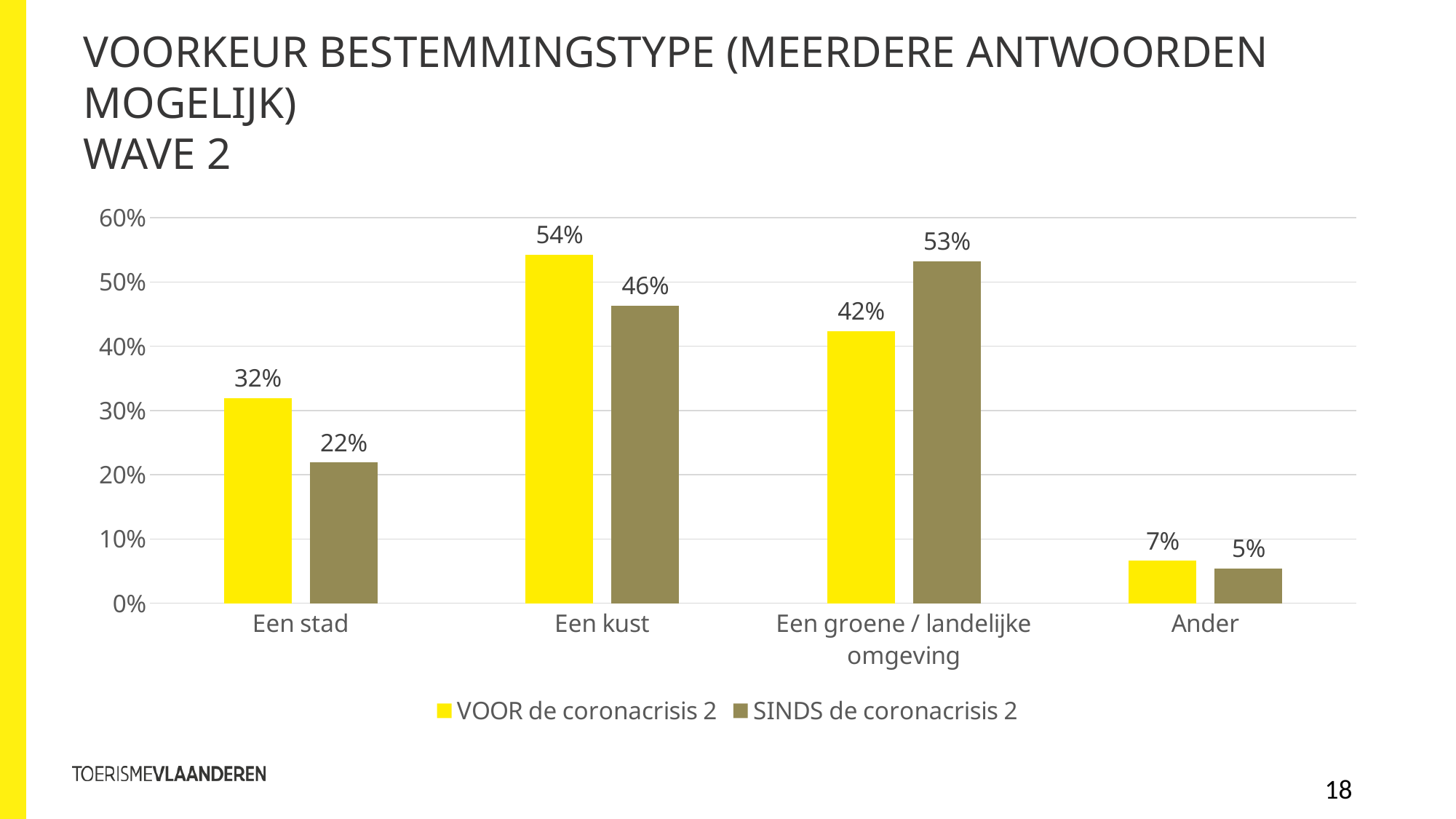
Which category has the lowest value in the 'SINDS de coronacrisis 2' series? Ander Is the 'SINDS de coronacrisis 2' value for 'Een kust' greater or less than 40%? greater How many series does the legend list? 2 What is the value for 'Ander' in the 'SINDS de coronacrisis 2' series? 5% What kind of chart is shown on the slide? Bar chart Which category has the highest value in the 'VOOR de coronacrisis 2' series? Een kust What is the difference between the 'VOOR de coronacrisis 2' and 'SINDS de coronacrisis 2' values for 'Een stad'? 10% How many categories are shown on the x axis? 4 For 'Een groene / landelijke omgeving', which series has the larger value: 'VOOR de coronacrisis 2' or 'SINDS de coronacrisis 2'? SINDS de coronacrisis 2 What is the value for 'Een groene / landelijke omgeving' in the 'SINDS de coronacrisis 2' series? 53% Which colour represents the 'VOOR de coronacrisis 2' series? Yellow What is the value for 'Een stad' in the 'VOOR de coronacrisis 2' series? 32%